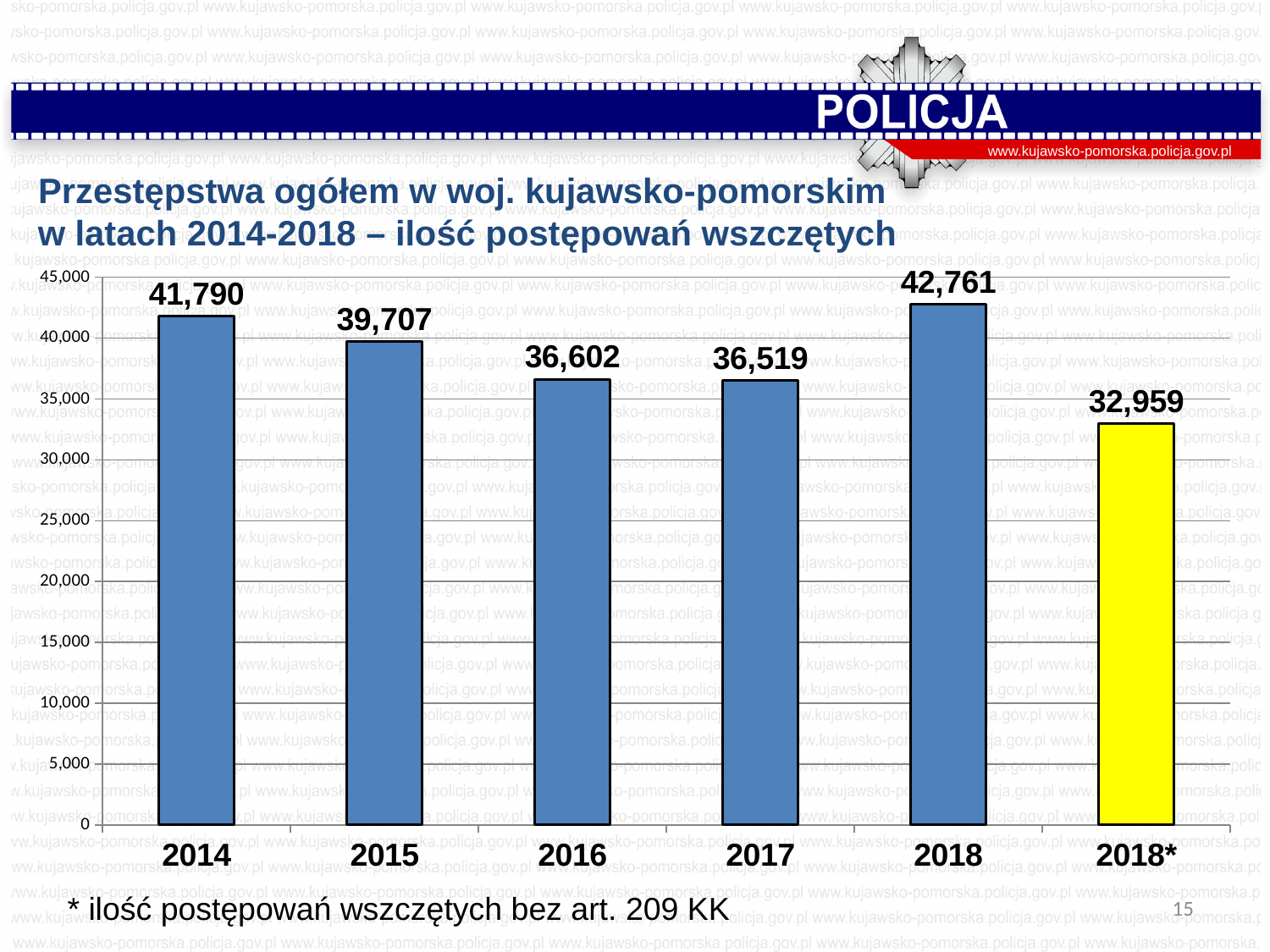
What is the value for the 2018* bar? 32,959 Which category has the highest value? 2018 How many bars are shown in the chart? 6 What is the value for 2016? 36,602 Is the value for 2017 greater or less than 35,000? greater What is the difference between the values for 2014 and 2015? 2,083 What is the value for 2014? 41,790 Which is larger, the value for 2015 or the value for 2016? 2015 Which category has the lowest value? 2018* Which bar is coloured yellow instead of blue? 2018* What kind of chart is shown on the slide? bar chart What is the difference between the values for 2018 and 2017? 6,242